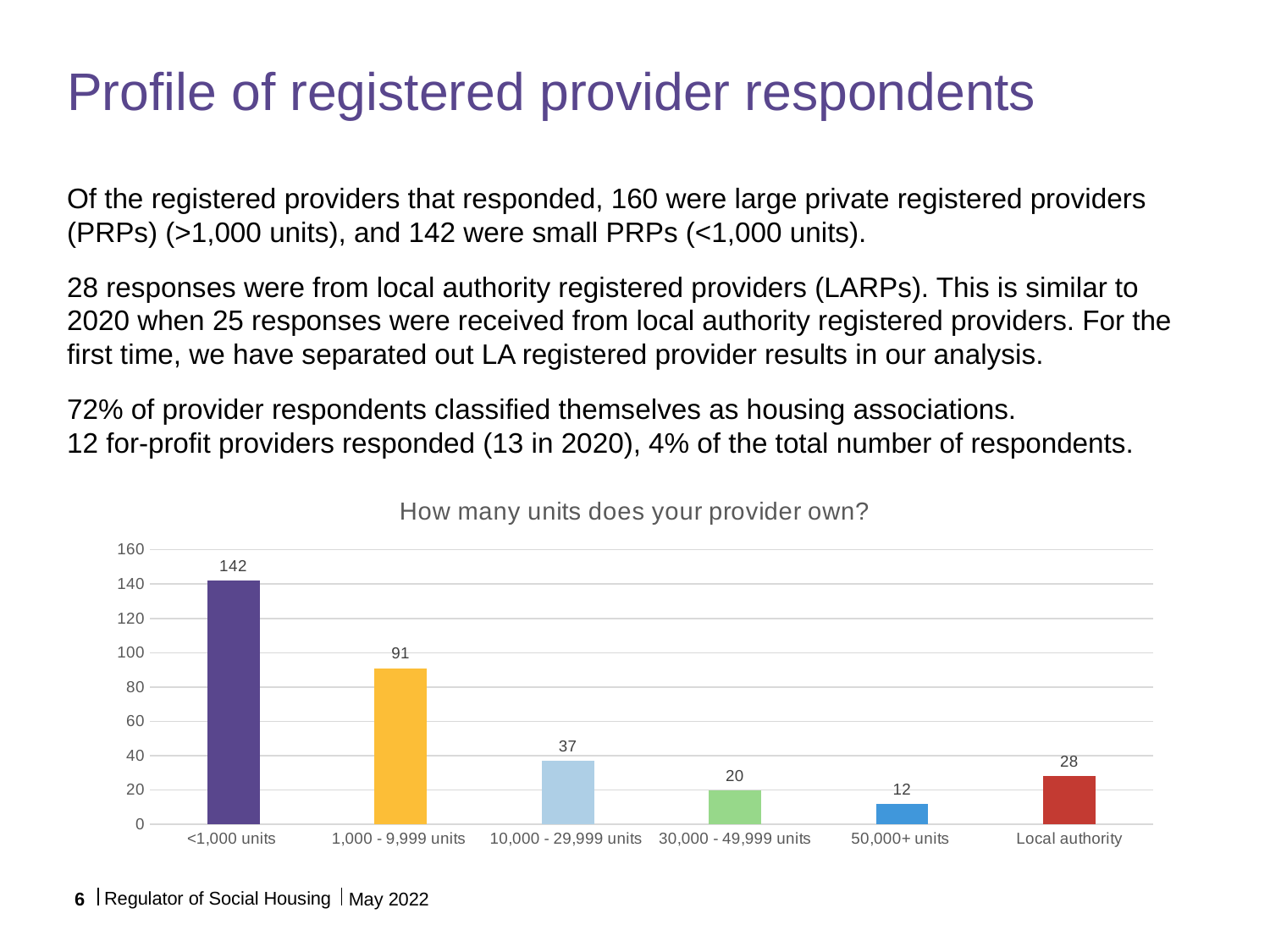
Which category has the highest value? <1,000 units How many categories are shown on the x axis? 6 What is the value for <1,000 units? 142 What is the title of the chart? How many units does your provider own? Is the value for 10,000 - 29,999 units greater or less than 40? less Which category has the lowest value? 50,000+ units Which is larger, the value for 30,000 - 49,999 units or the value for Local authority? Local authority What is the value for Local authority? 28 What kind of chart is shown? bar chart What is the value for 1,000 - 9,999 units? 91 What is the value for 10,000 - 29,999 units? 37 What is the difference between the values for <1,000 units and 1,000 - 9,999 units? 51